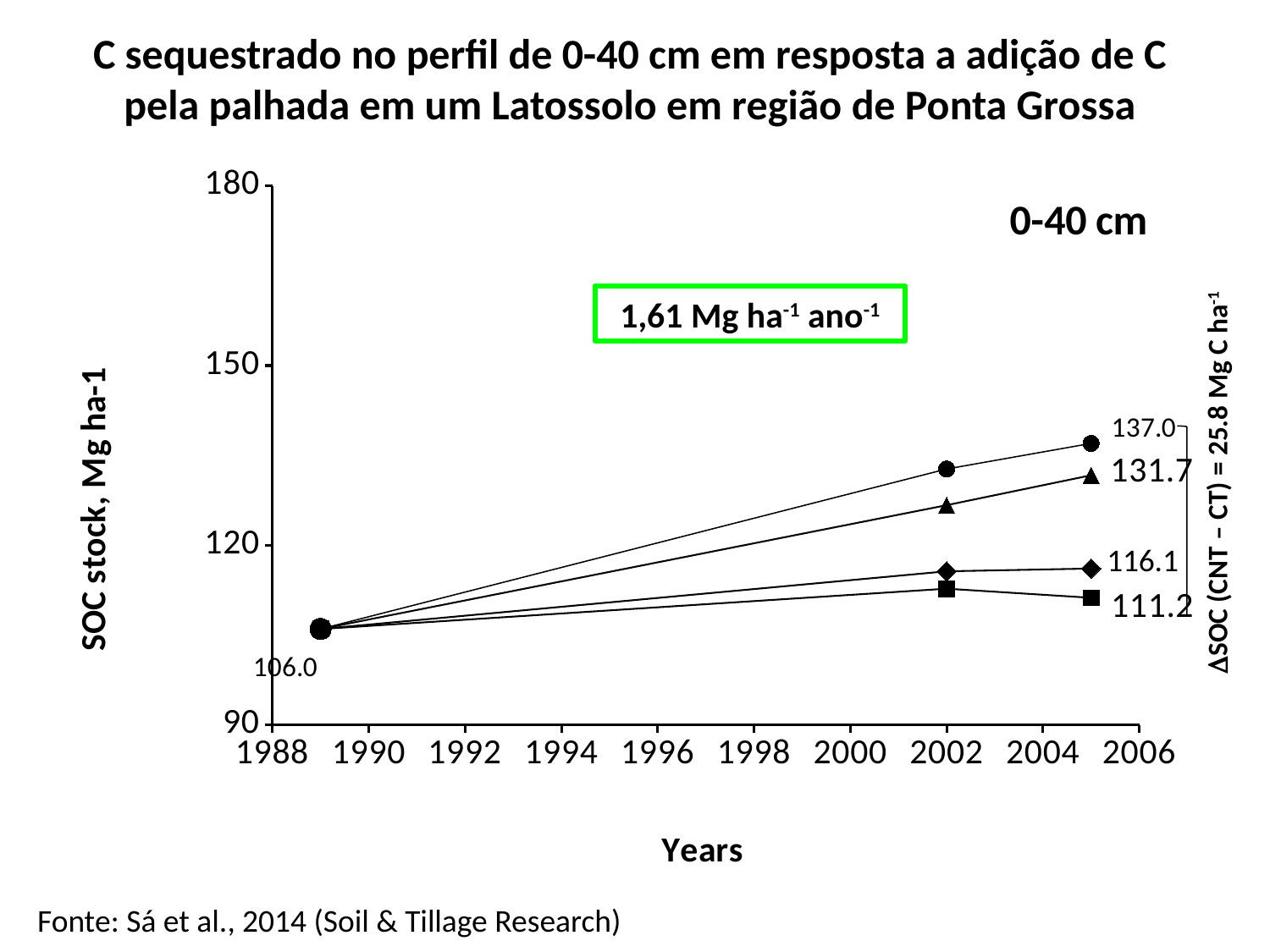
What is the SOC stock value printed at the 2005 end of the line with triangle markers? 131.7 Is the 2002 value of the circle-marker line greater or less than 120? greater What kind of chart is shown on the slide? line chart What is the SOC stock value printed at the 2005 end of the line with square markers? 111.2 What is the SOC stock value printed at the 2005 end of the line with diamond markers? 116.1 What annual rate is shown in the green box on the chart? 1,61 Mg ha-1 ano-1 What is the difference between the 2005 values of the circle-marker line (137.0) and the square-marker line (111.2)? 25.8 Does the circle-marker line rise or fall from 1989 to 2005? rise Which line has the lowest SOC stock value in 2005? the line with square markers (111.2) Which line has the highest SOC stock value in 2005? the line with circle markers (137.0) What is the SOC stock value printed at the 2005 end of the line with circle markers? 137.0 What is the starting SOC stock value printed at 1989, where all lines begin? 106.0